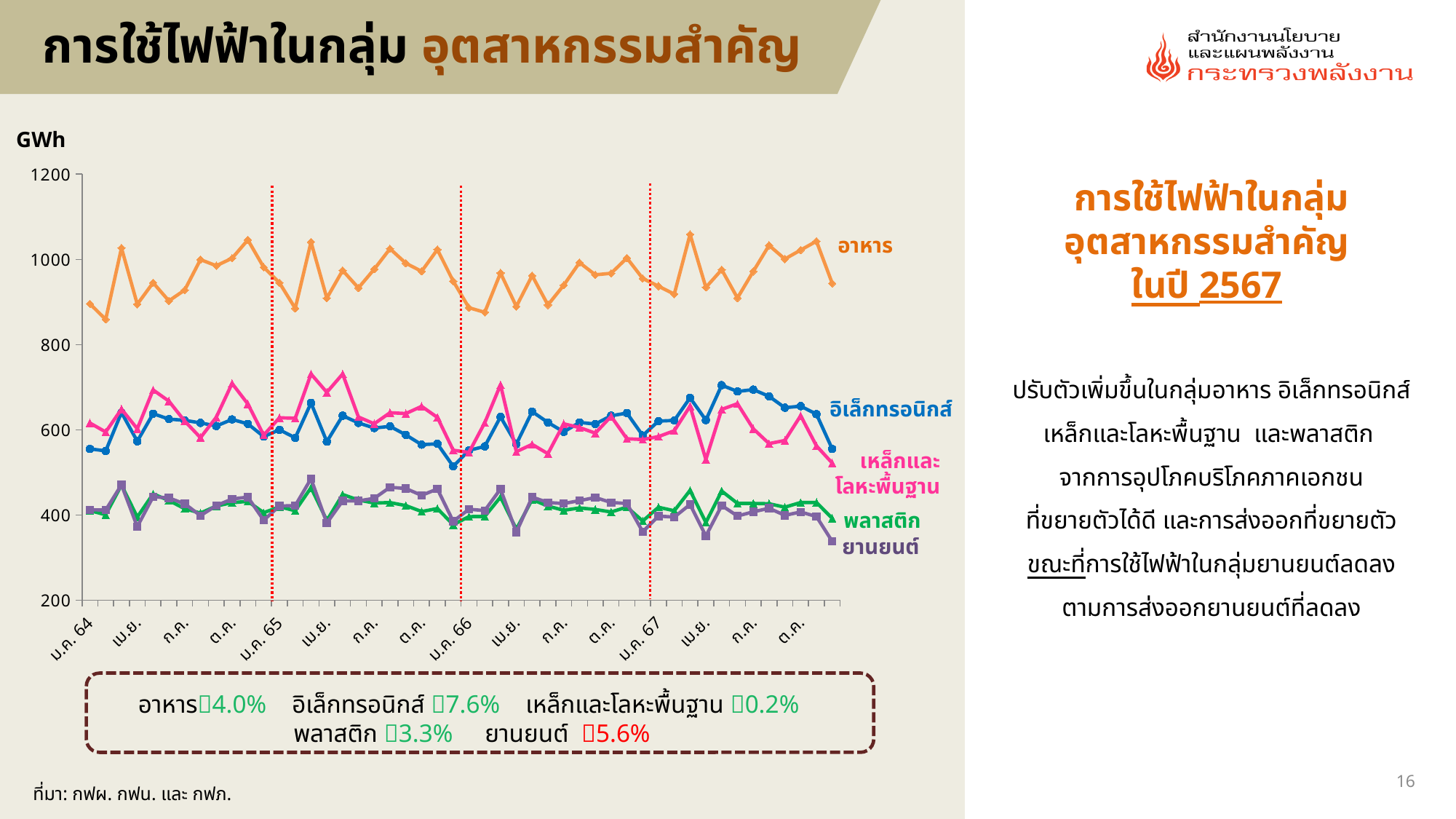
What kind of chart is shown on the slide? line chart What unit is shown on the y axis of the chart? GWh Is the value for ยานยนต์ at the last plotted point greater or less than 400? less Does the ยานยนต์ line rise or fall over the last few points of the chart? fall How many series (industry groups) are plotted on the chart? 5 Which series has the lowest value at the last plotted point on the chart? ยานยนต์ Is the value for อาหาร at ม.ค. 64 greater or less than 800? greater Which series has larger values, อาหาร or พลาสติก? อาหาร Which series has the highest values throughout the chart? อาหาร Is the value for อิเล็กทรอนิกส์ at ม.ค. 64 greater or less than 600? less What is the maximum value shown on the y axis of the chart? 1200